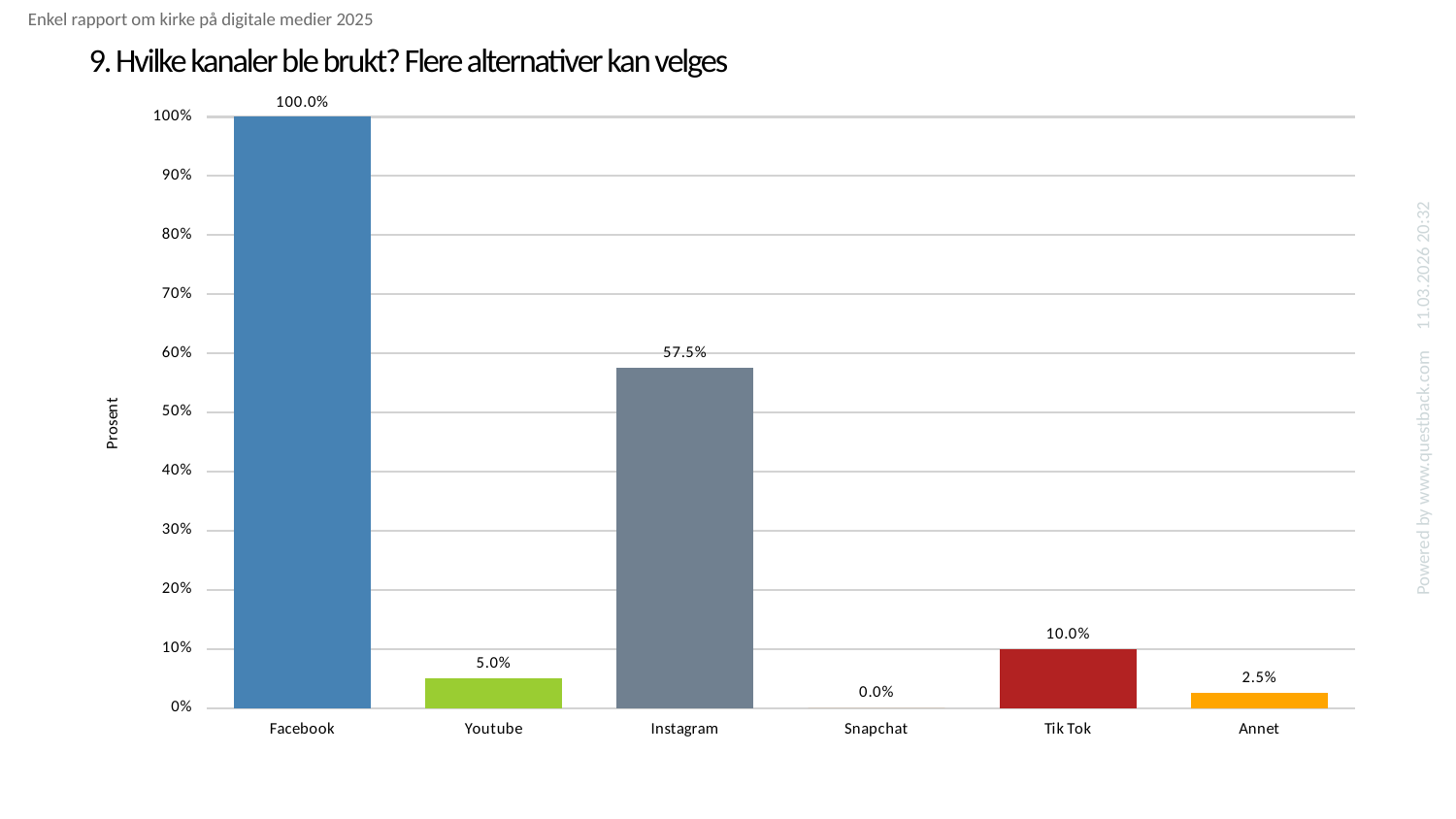
What is the label of the y axis? Prosent What is the value for Instagram? 57.5% Which category has the highest value? Facebook What is the value for Snapchat? 0.0% What is the value for Facebook? 100.0% What is the difference between the values for Tik Tok and Youtube? 5.0% What is the difference between the values for Facebook and Instagram? 42.5% What kind of chart is shown on the slide? Bar chart Which category has the lowest value? Snapchat How many categories are shown on the x axis? 6 Which is larger, the value for Youtube or the value for Annet? Youtube What is the value for Tik Tok? 10.0%